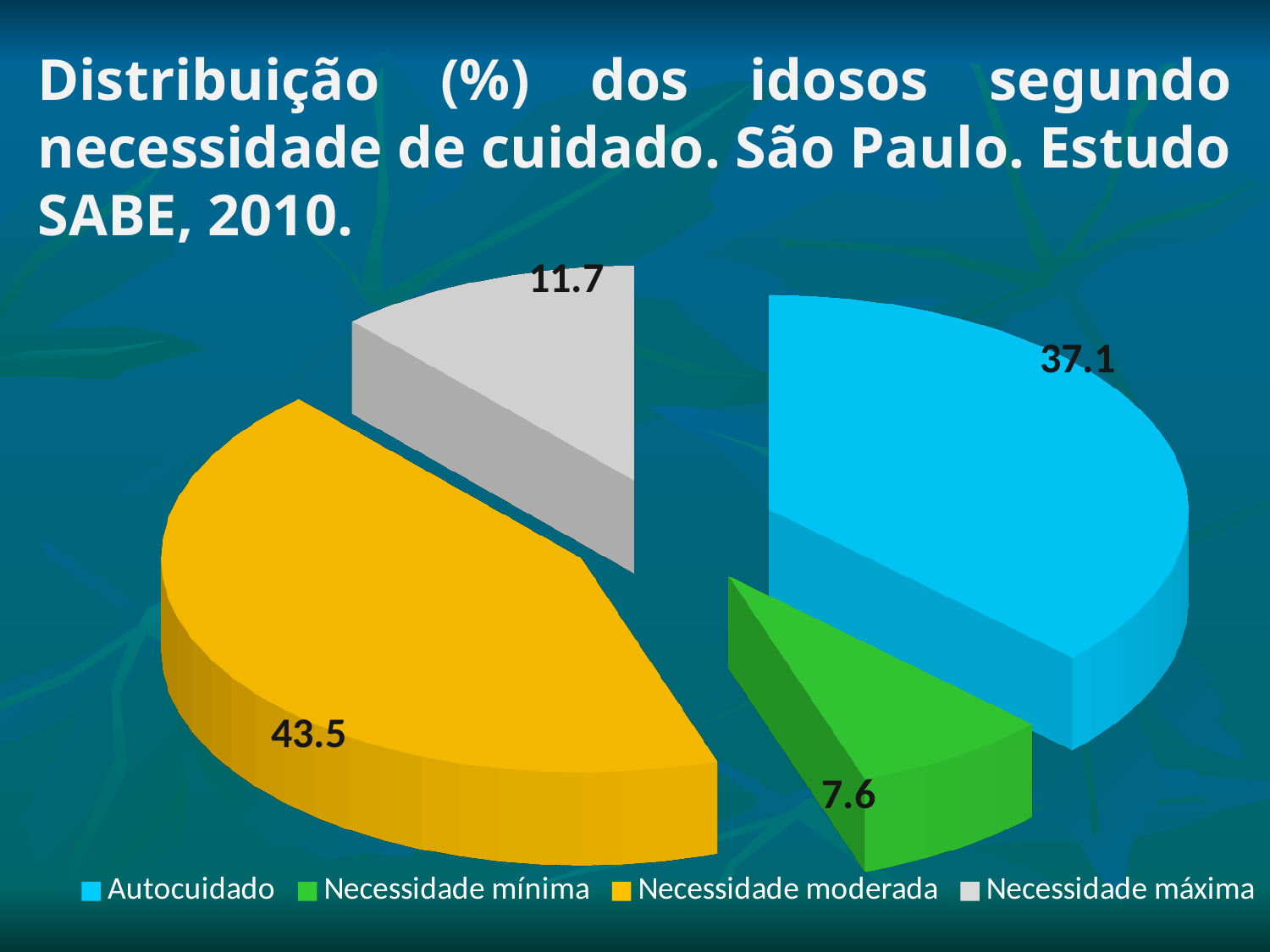
What is the difference between the values for Necessidade máxima and Necessidade mínima? 4.1 What kind of chart is shown on the slide? pie chart What is the value for Necessidade mínima? 7.6 What is the difference between the values for Necessidade moderada and Autocuidado? 6.4 Which category has the smallest slice? Necessidade mínima Which colour represents Necessidade mínima in the legend? green What is the value for Necessidade moderada? 43.5 Which is larger, the value for Autocuidado or the value for Necessidade máxima? Autocuidado How many slices does the pie chart have? 4 Which category has the largest slice? Necessidade moderada What is the value for Autocuidado? 37.1 What is the value for Necessidade máxima? 11.7